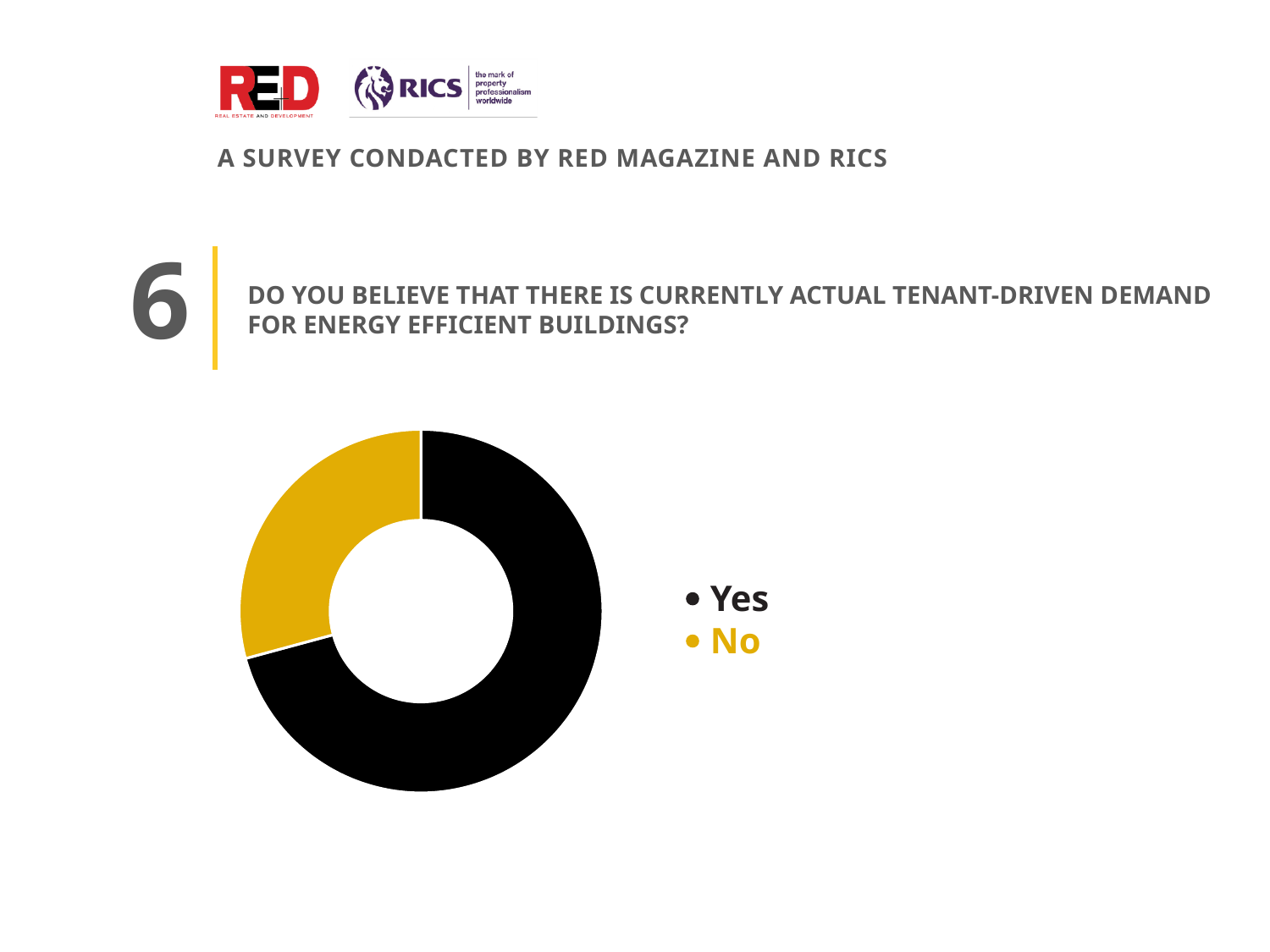
What colour represents the No category? Yellow What colour represents the Yes category? Black Which category has the smallest share of the chart? No Which category has the largest share of the chart? Yes What kind of chart is shown on the slide? Doughnut (pie) chart Which is larger, the share for Yes or the share for No? Yes What are the two legend entries of the chart? Yes and No How many categories does the chart show? 2